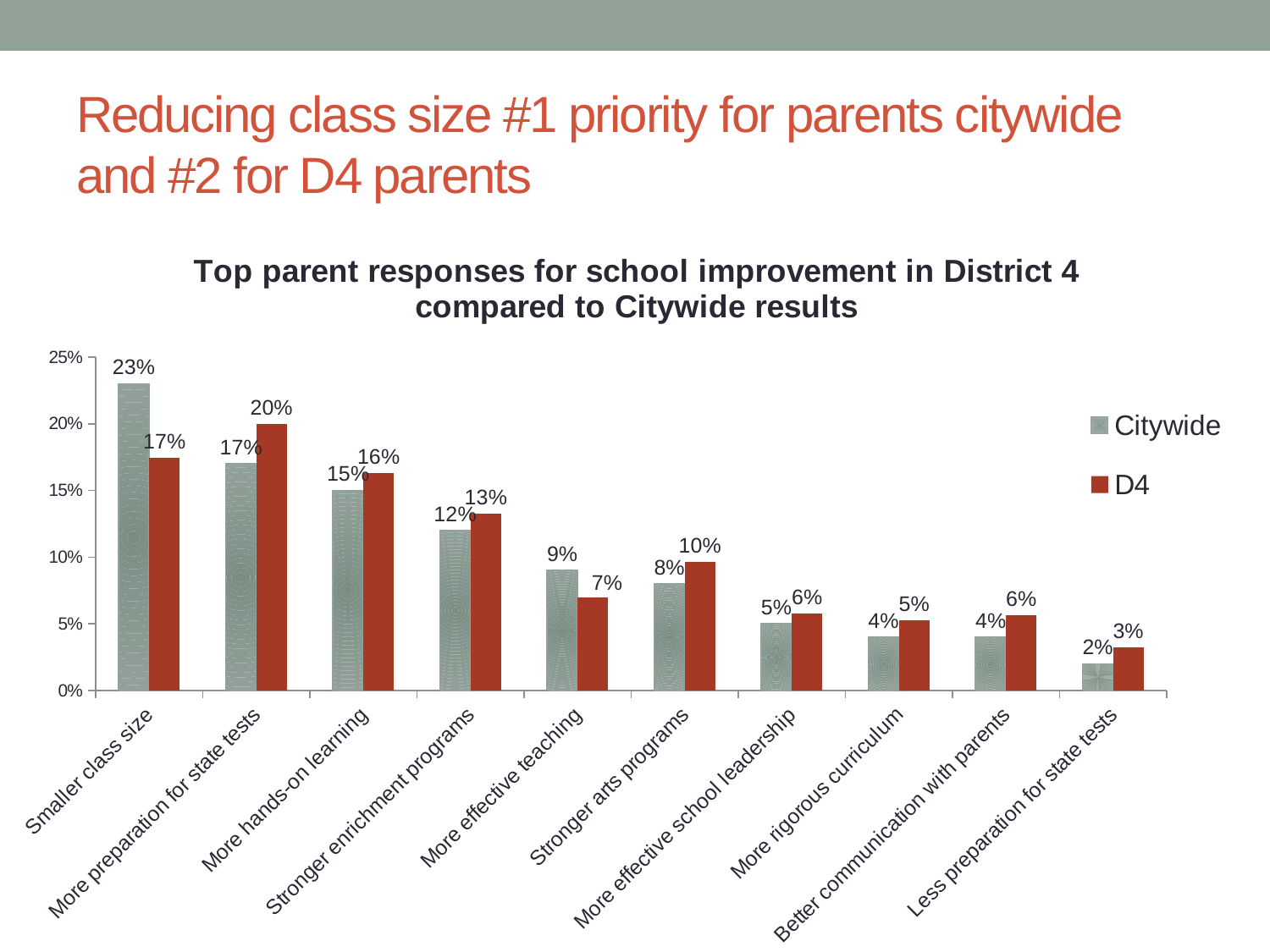
How many categories are shown on the x axis? 10 How many series does the legend list? 2 Which is larger for More effective teaching, the Citywide value or the D4 value? Citywide What is the difference between the Citywide and D4 values for Smaller class size? 6% What is the D4 value for More preparation for state tests? 20% Do the Citywide values rise or fall from left to right along the x axis? Fall What is the Citywide value for Smaller class size? 23% What is the D4 value for Stronger arts programs? 10% What is the title of the chart? Top parent responses for school improvement in District 4 compared to Citywide results What kind of chart is shown on the slide? Bar chart Which category has the lowest D4 value? Less preparation for state tests Which category has the highest Citywide value? Smaller class size